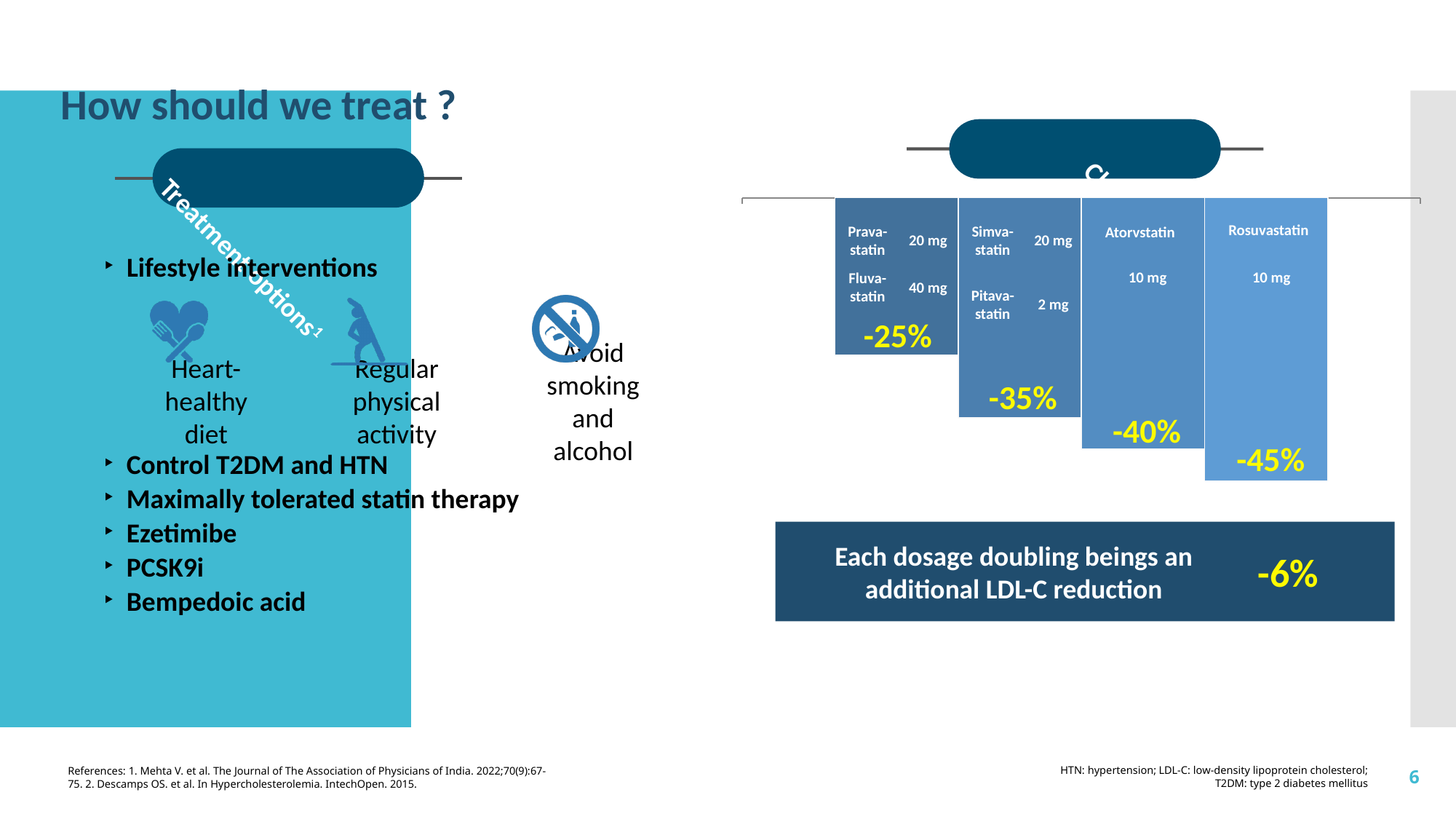
How many bars are in the bar chart on the right? 4 In the bar chart on the right, what LDL-C reduction is shown for Atorvastatin 10 mg? -40% In the bar chart on the right, which bar shows the smallest LDL-C reduction? Pravastatin 20 mg / Fluvastatin 40 mg (-25%) In the bar chart on the right, which statin bar shows the largest LDL-C reduction? Rosuvastatin 10 mg According to the box below the bar chart, what additional LDL-C reduction does each dosage doubling bring? -6% In the bar chart on the right, what reduction is shown for the bar containing Pravastatin 20 mg and Fluvastatin 40 mg? -25% In the bar chart on the right, what LDL-C reduction is shown for Rosuvastatin 10 mg? -45% In the bar chart on the right, what is the difference in percentage points between the Rosuvastatin 10 mg reduction and the Atorvastatin 10 mg reduction? 5 percentage points In the bar chart on the right, what reduction is shown for the bar containing Simvastatin 20 mg and Pitavastatin 2 mg? -35% In the bar chart on the right, which shows a greater LDL-C reduction: Atorvastatin 10 mg or Simvastatin 20 mg? Atorvastatin 10 mg In the bar chart on the right, do the LDL-C reductions get larger or smaller moving from left to right? Larger What kind of chart is shown on the right of the slide? Bar chart